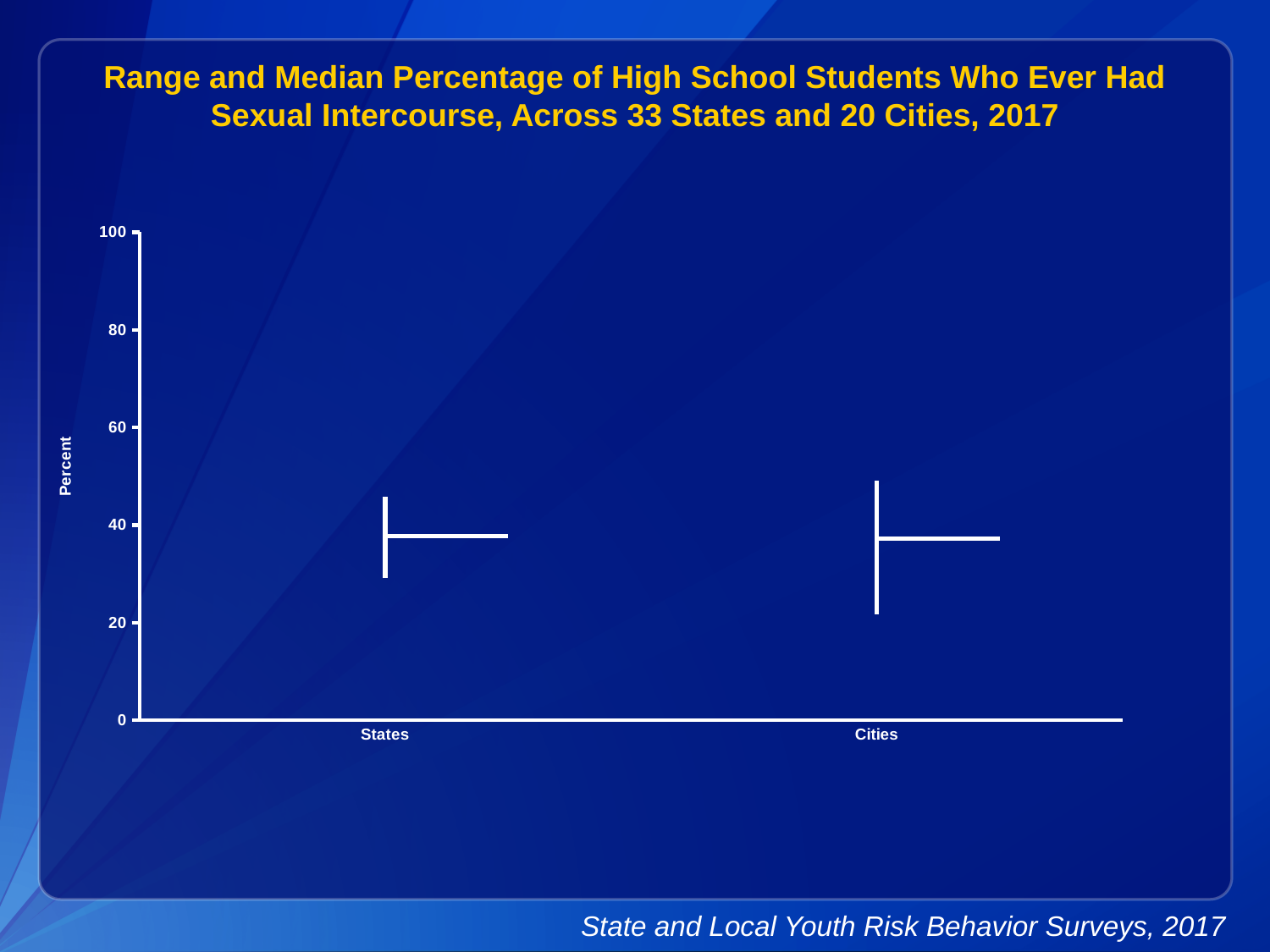
Is the top of the range for States greater or less than 40? greater Is the bottom of the range for Cities greater or less than 20? greater Is the median value for States greater or less than 40? less What is the highest value shown on the vertical axis? 100 What is the label on the vertical axis? Percent Which category has the wider range, States or Cities? Cities What is the title of the chart? Range and Median Percentage of High School Students Who Ever Had Sexual Intercourse, Across 33 States and 20 Cities, 2017 How many categories are shown on the x axis? 2 Which category has the lower bottom of its range, States or Cities? Cities